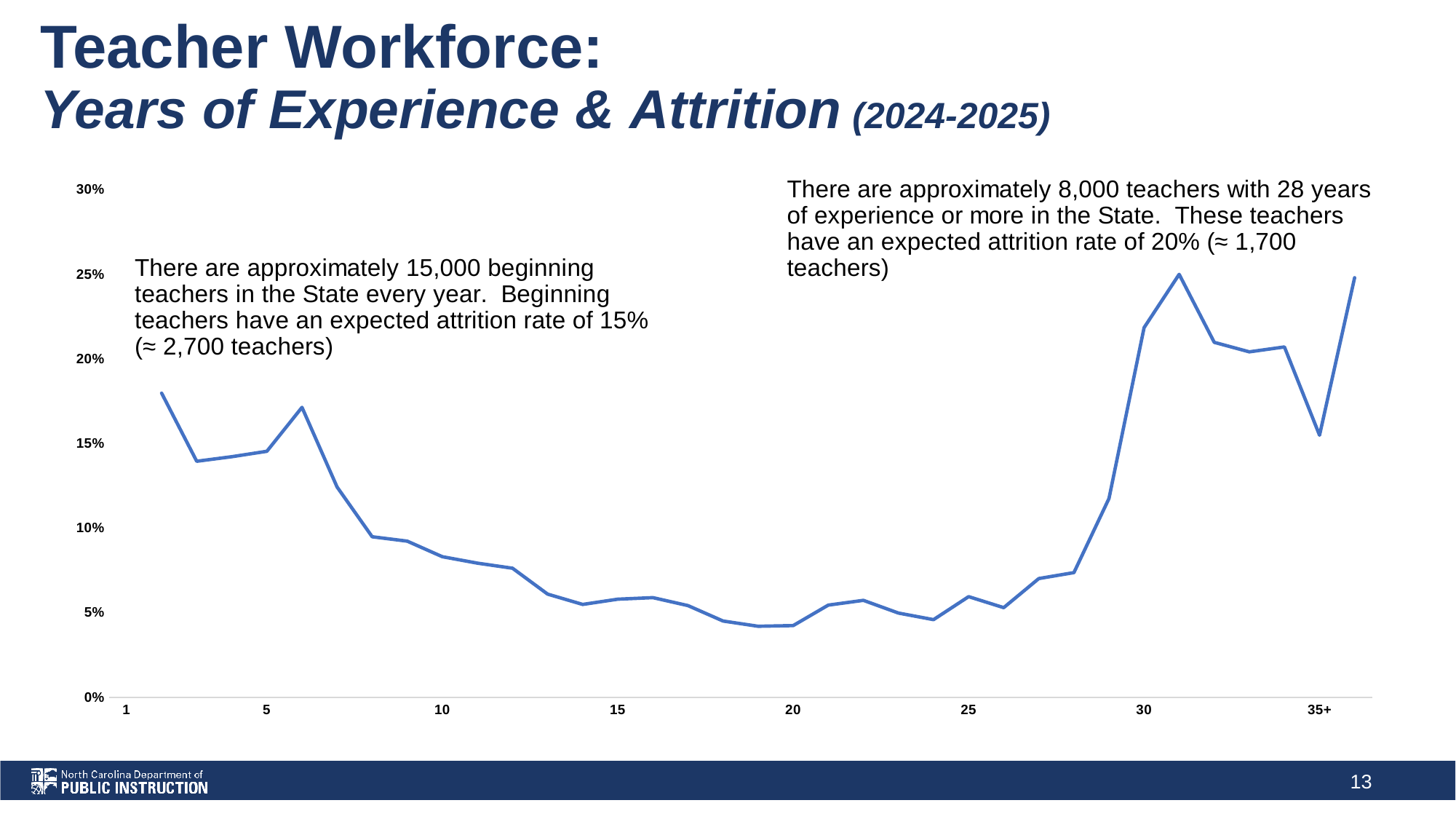
Is the attrition rate at 30 years of experience greater or less than 20%? greater What kind of chart is shown on the slide? line chart Is the attrition rate at 20 years of experience greater or less than 5%? less What is the highest value labelled on the y axis of the chart? 30% Is the attrition rate at 10 years of experience greater or less than 10%? less Which has the higher attrition rate: 10 years of experience or 30 years of experience? 30 years of experience How many labelled tick marks are on the x axis of the chart? 8 Does the attrition rate rise or fall as years of experience increase from 20 to 30? rise Does the attrition rate rise or fall as years of experience increase from 1 to 20? fall